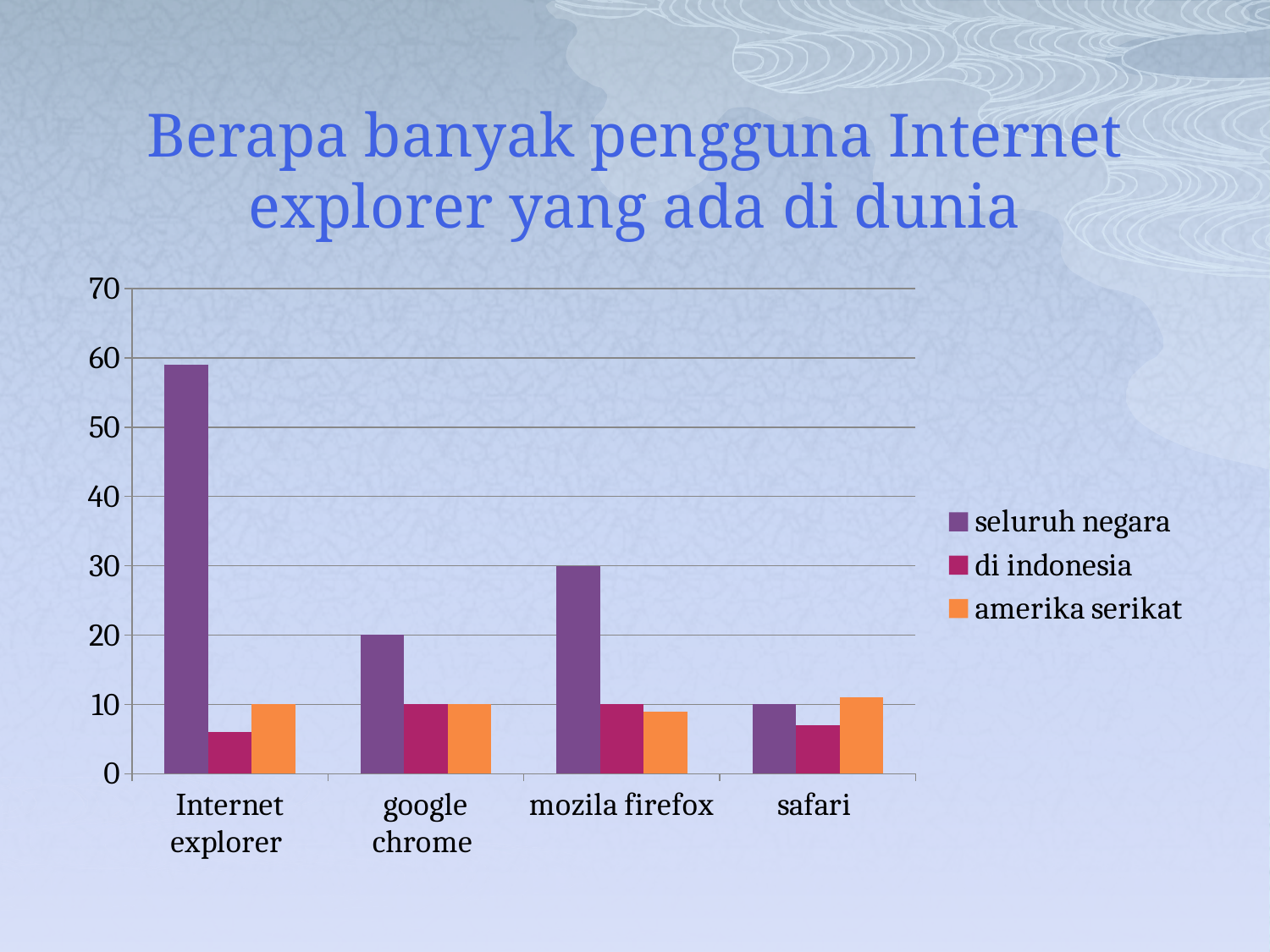
What kind of chart is shown on the slide? bar chart Which series is shown in orange in the legend? amerika serikat How many browser categories are shown on the x axis? 4 Is the 'seluruh negara' value for Internet explorer greater or less than 50? greater What is the 'seluruh negara' value for mozila firefox? 30 How many series does the legend list? 3 Is the 'di indonesia' value for Internet explorer greater or less than 10? less Which browser has the lowest value for the 'seluruh negara' series? safari Which is larger for Internet explorer: the 'di indonesia' value or the 'amerika serikat' value? amerika serikat Which is larger for mozila firefox: the 'seluruh negara' value or the 'di indonesia' value? seluruh negara What is the 'seluruh negara' value for google chrome? 20 Which browser has the highest value for the 'seluruh negara' series? Internet explorer